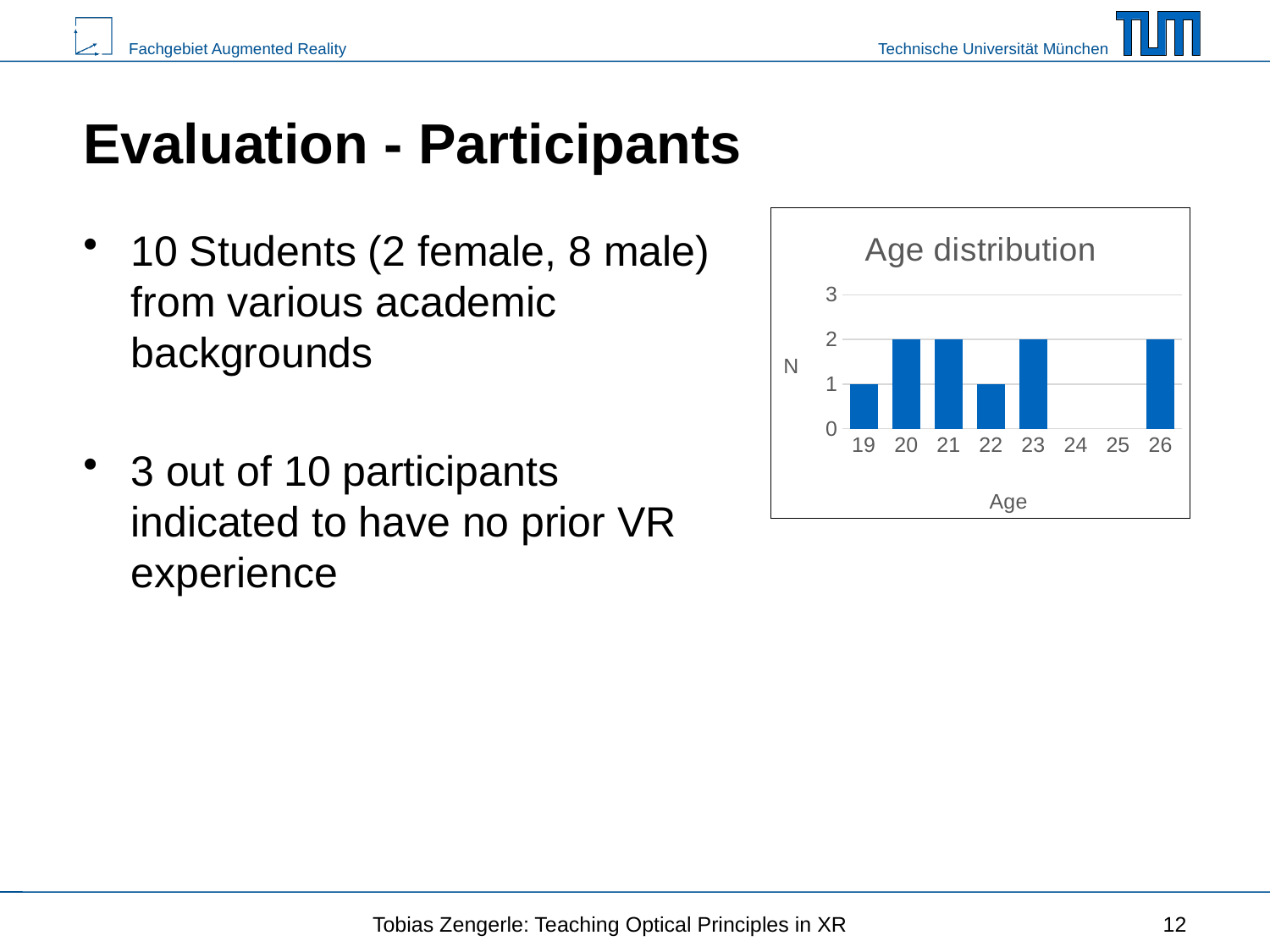
How many age categories are shown on the x axis of the "Age distribution" chart? 8 Is the value of N for age 20 in the "Age distribution" chart greater or less than 3? less What is the value of N for age 20 in the "Age distribution" chart? 2 What is the title of the chart on the slide? Age distribution What is the value of N for age 24 in the "Age distribution" chart? 0 What is the value of N for age 26 in the "Age distribution" chart? 2 Which has a larger value of N in the "Age distribution" chart, age 21 or age 22? age 21 What is the value of N for age 19 in the "Age distribution" chart? 1 What type of chart is the "Age distribution" chart? bar chart What is the value of N for age 22 in the "Age distribution" chart? 1 What is the label of the y axis in the "Age distribution" chart? N What is the difference in N between age 23 and age 19 in the "Age distribution" chart? 1